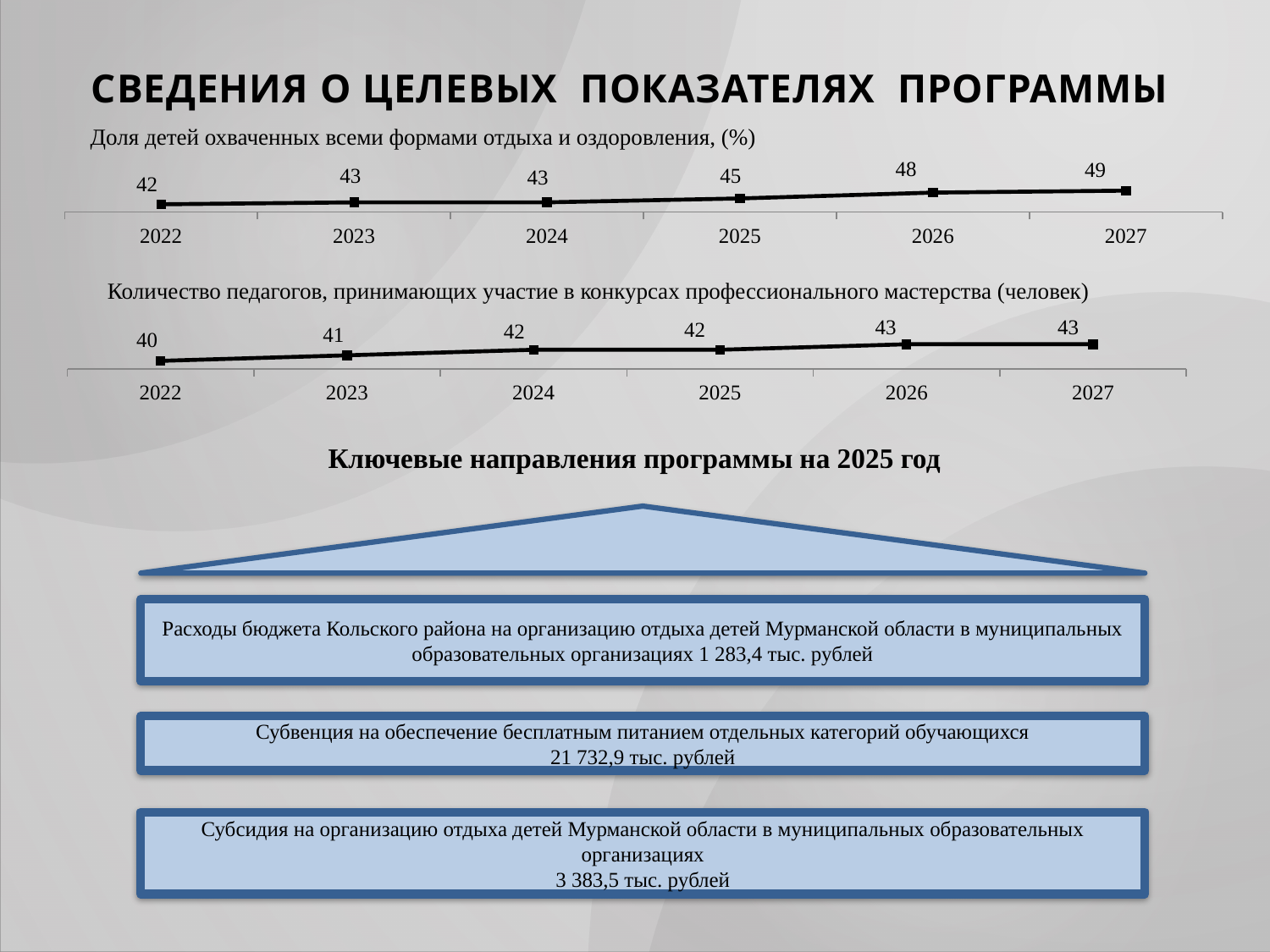
In the top chart (share of children covered by all forms of recreation), what is the difference between the 2027 and 2022 values? 7 In the bottom chart (number of teachers participating in professional skill competitions), what is the value for 2026? 43 In the bottom chart (number of teachers participating in professional skill competitions), which year has the lowest value? 2022 How many years are plotted in the top chart (share of children covered by all forms of recreation)? 6 In the top chart (share of children covered by all forms of recreation), do the values rise or fall from 2022 to 2027? rise In the top chart (share of children covered by all forms of recreation), what is the value for 2025? 45 In the bottom chart (number of teachers participating in professional skill competitions), what is the value for 2023? 41 In the top chart (share of children covered by all forms of recreation), which year has the highest value? 2027 What type of chart is the top chart (share of children covered by all forms of recreation)? line chart In the top chart (share of children covered by all forms of recreation), what is the value for 2022? 42 In the bottom chart (number of teachers participating in professional skill competitions), what is the difference between the 2027 and 2022 values? 3 Which is larger: the 2024 value in the top chart (share of children) or the 2024 value in the bottom chart (number of teachers)? the top chart (43)